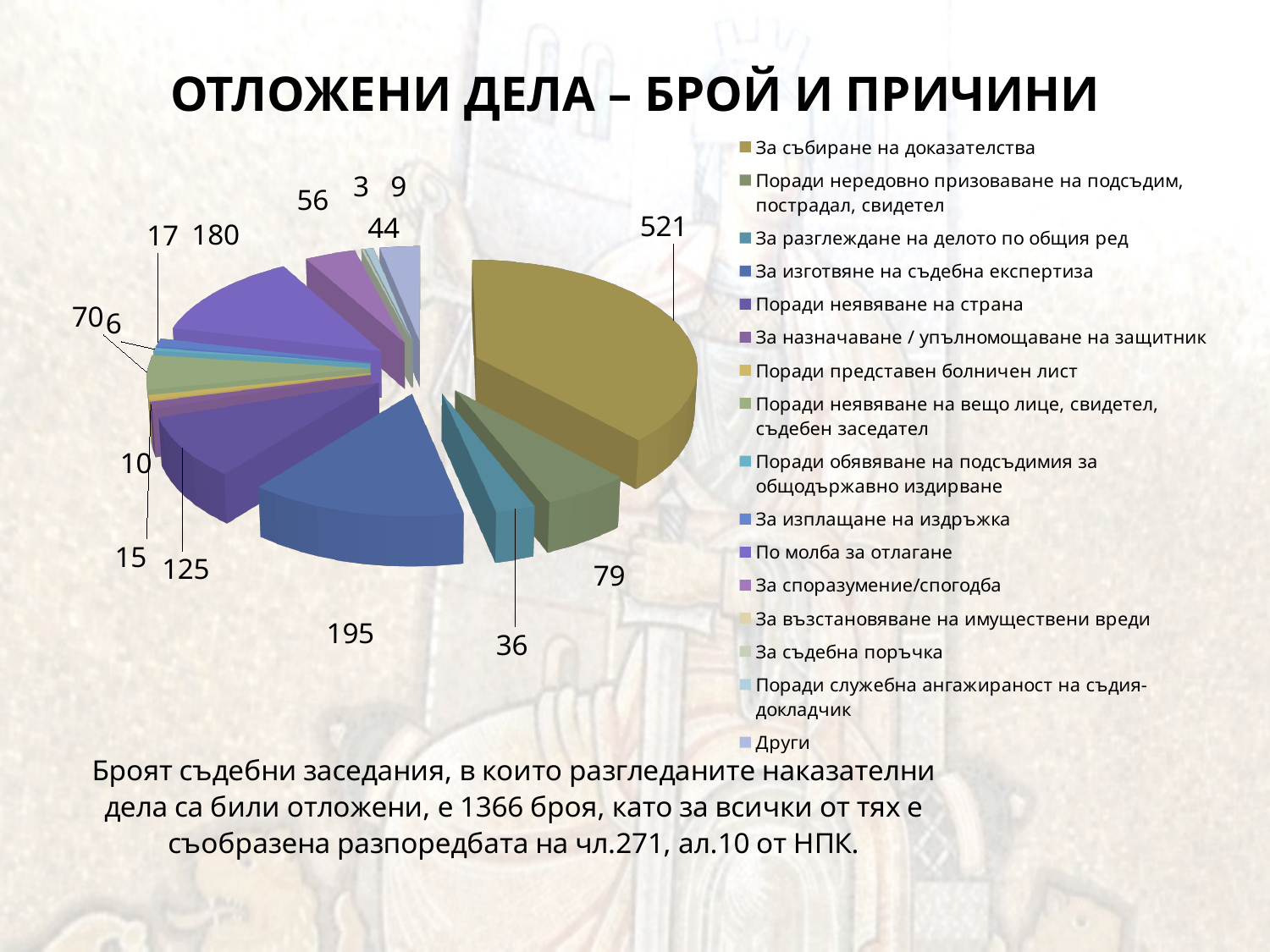
Which category has the largest slice in the pie chart? За събиране на доказателства What is the title of the slide's chart? ОТЛОЖЕНИ ДЕЛА – БРОЙ И ПРИЧИНИ What is the value for 'За разглеждане на делото по общия ред'? 36 Which is larger, the value for 'За събиране на доказателства' or the value for 'За изготвяне на съдебна експертиза'? За събиране на доказателства What is the value for 'Поради нередовно призоваване на подсъдим, пострадал, свидетел'? 79 What kind of chart is shown on the slide? pie chart What is the value for 'Поради неявяване на страна'? 125 What is the value for 'По молба за отлагане'? 180 How many entries does the chart's legend list? 16 What is the difference between the values for 'За събиране на доказателства' (521) and 'За изготвяне на съдебна експертиза' (195)? 326 What is the value for 'За събиране на доказателства'? 521 What is the value for 'За изготвяне на съдебна експертиза'? 195